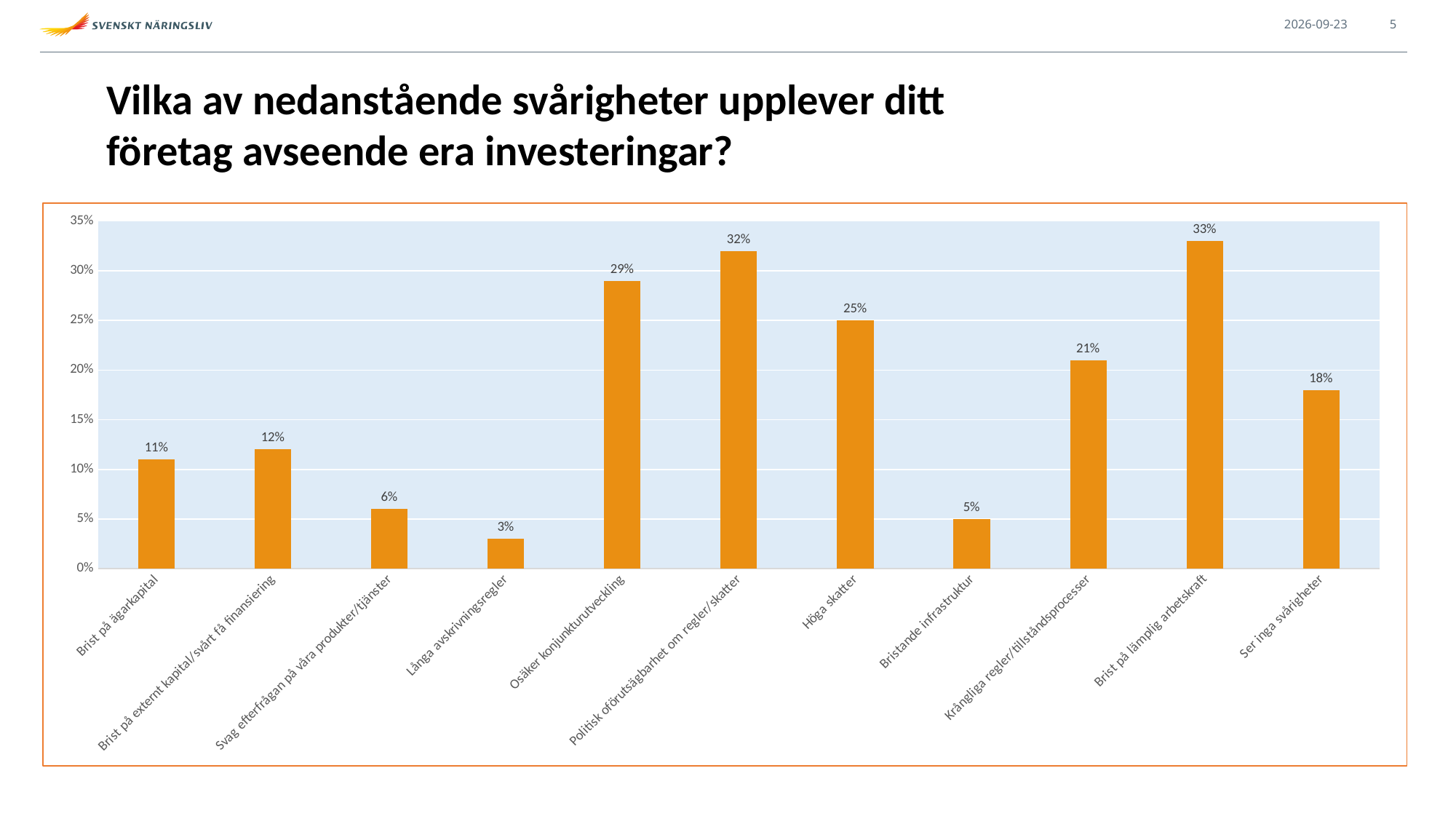
What is the value for "Osäker konjunkturutveckling"? 29% What is the difference between "Brist på lämplig arbetskraft" and "Brist på ägarkapital"? 22 percentage points How many categories are shown on the chart? 11 Which category has the highest value? Brist på lämplig arbetskraft What is the difference between "Politisk oförutsägbarhet om regler/skatter" and "Bristande infrastruktur"? 27 percentage points What is the value for "Höga skatter"? 25% What is the maximum value shown on the vertical axis? 35% What kind of chart is shown on the slide? Bar chart What is the value for "Ser inga svårigheter"? 18% Which category has the lowest value? Långa avskrivningsregler Is the value for "Svag efterfrågan på våra produkter/tjänster" greater or less than 10%? less Which is larger, "Krångliga regler/tillståndsprocesser" or "Brist på externt kapital/svårt få finansiering"? Krångliga regler/tillståndsprocesser